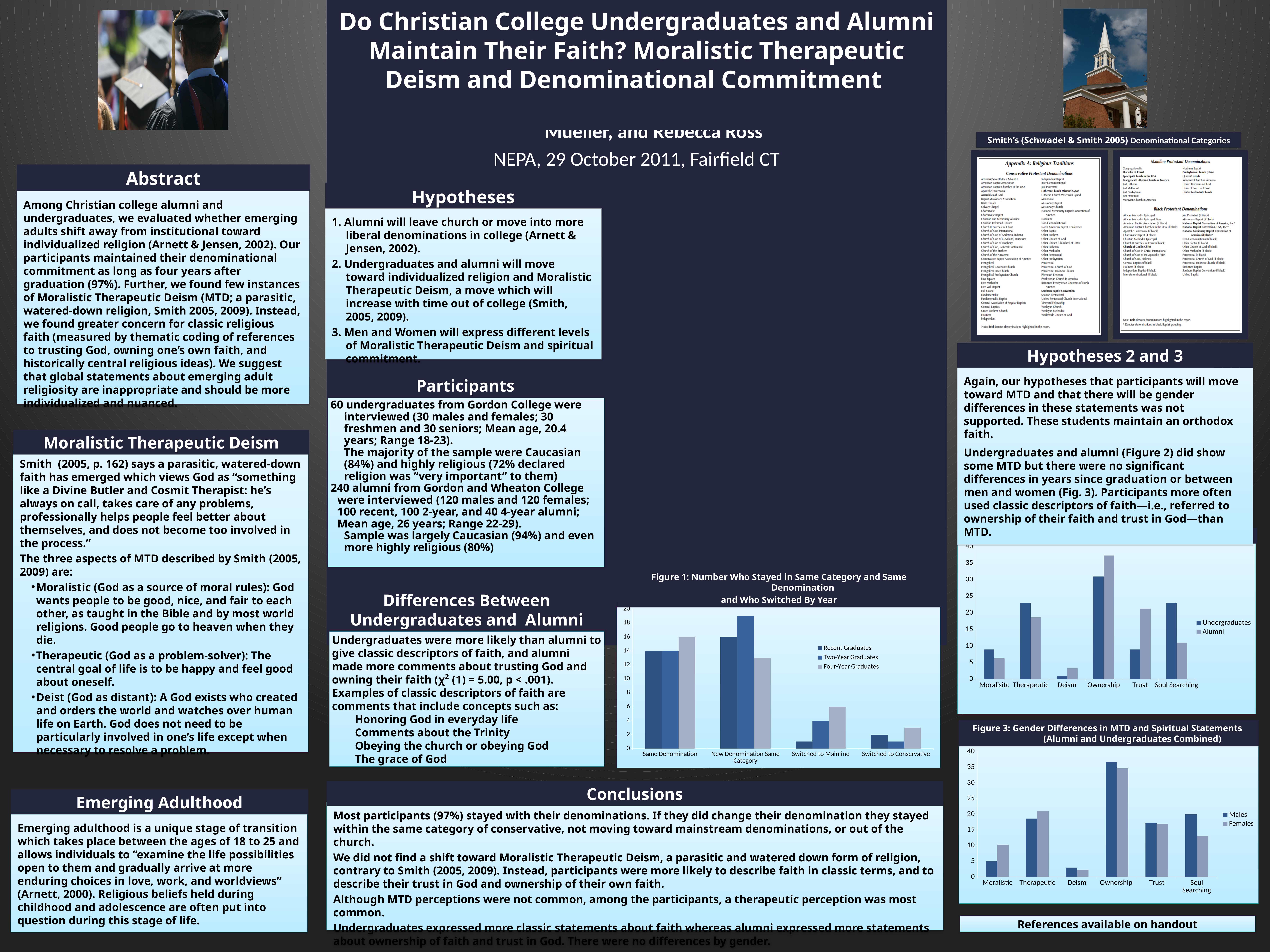
In Figure 1, is the value for Two-Year Graduates in the New Denomination Same Category group greater or less than 18? greater In Figure 1, how many categories are shown on the x axis? 4 In Figure 3, is the value for Females in the Ownership category greater or less than 30? greater In Figure 1, what is the value for Four-Year Graduates in the Same Denomination category? 16 In Figure 3, what is the value for Males in the Moralistic category? 5 In Figure 1, what kind of chart is shown? bar chart In Figure 3, which category has the highest value for Males? Ownership In Figure 1, which series has the highest value in the New Denomination Same Category group? Two-Year Graduates In Figure 1, how many series does the legend list? 3 In the Undergraduates/Alumni chart in the upper right, which is larger for the Trust category, Undergraduates or Alumni? Alumni In Figure 3, how many series does the legend list? 2 In Figure 1, which series has the lowest value in the Switched to Mainline category? Recent Graduates